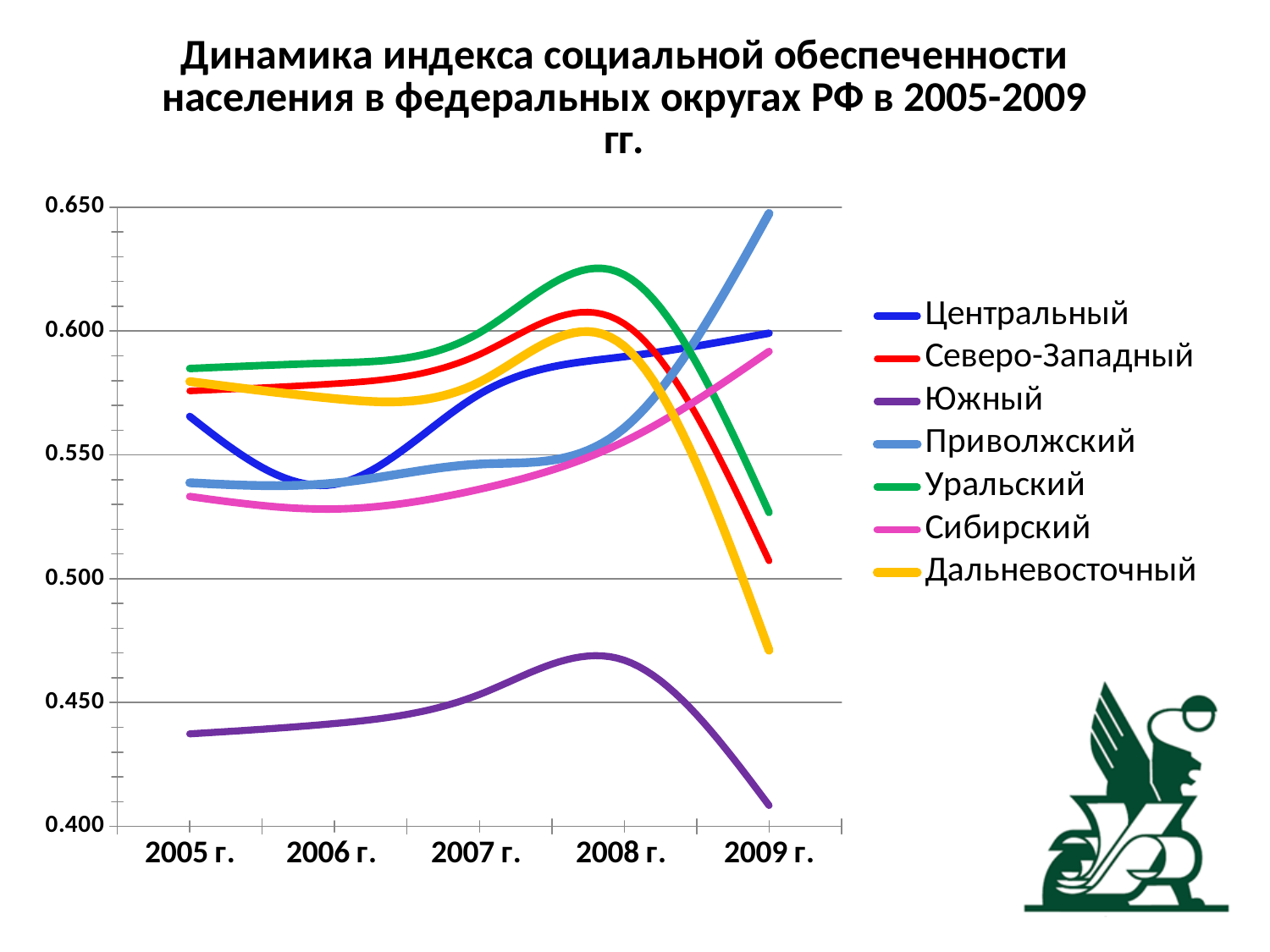
Which federal district has the highest value in 2008 г.? Уральский Which is larger in 2005 г., the value for Центральный or the value for Приволжский? Центральный How many series does the legend list? 7 Is the value for Дальневосточный in 2009 г. greater or less than 0.500? less Which series is drawn in purple in the legend? Южный Is the value for Приволжский in 2009 г. greater or less than 0.600? greater Which federal district has the highest value in 2009 г.? Приволжский What kind of chart is shown on the slide? line chart How many years are plotted along the x axis? 5 Which federal district has the lowest value in 2009 г.? Южный Does the value for Дальневосточный rise or fall from 2008 г. to 2009 г.? fall Is the value for Южный in 2005 г. greater or less than 0.450? less